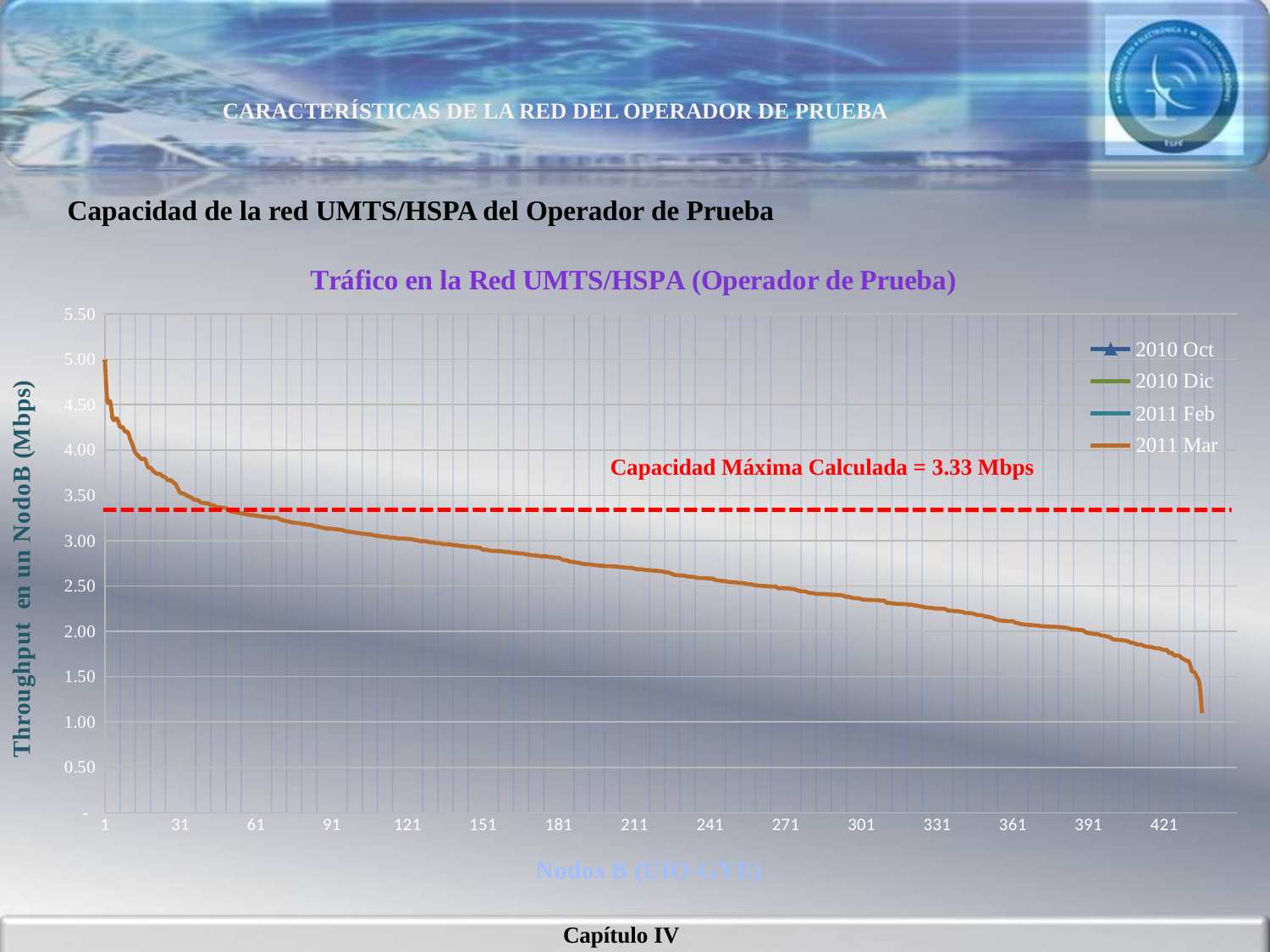
Is the throughput value at node 211 greater or less than 3.00 Mbps? less Do the throughput values rise or fall as the node number increases along the x axis? fall How many series does the legend of the chart list? 4 Is the throughput value at node 1 greater or less than 4.50 Mbps? greater Is the throughput value at node 91 greater or less than 3.50 Mbps? less What kind of chart is shown on the slide? line chart Which is larger, the throughput at node 121 or at node 301? node 121 What is the title of the chart? Tráfico en la Red UMTS/HSPA (Operador de Prueba) What maximum capacity value is annotated on the chart? 3.33 Mbps At which node number is the throughput highest? 1